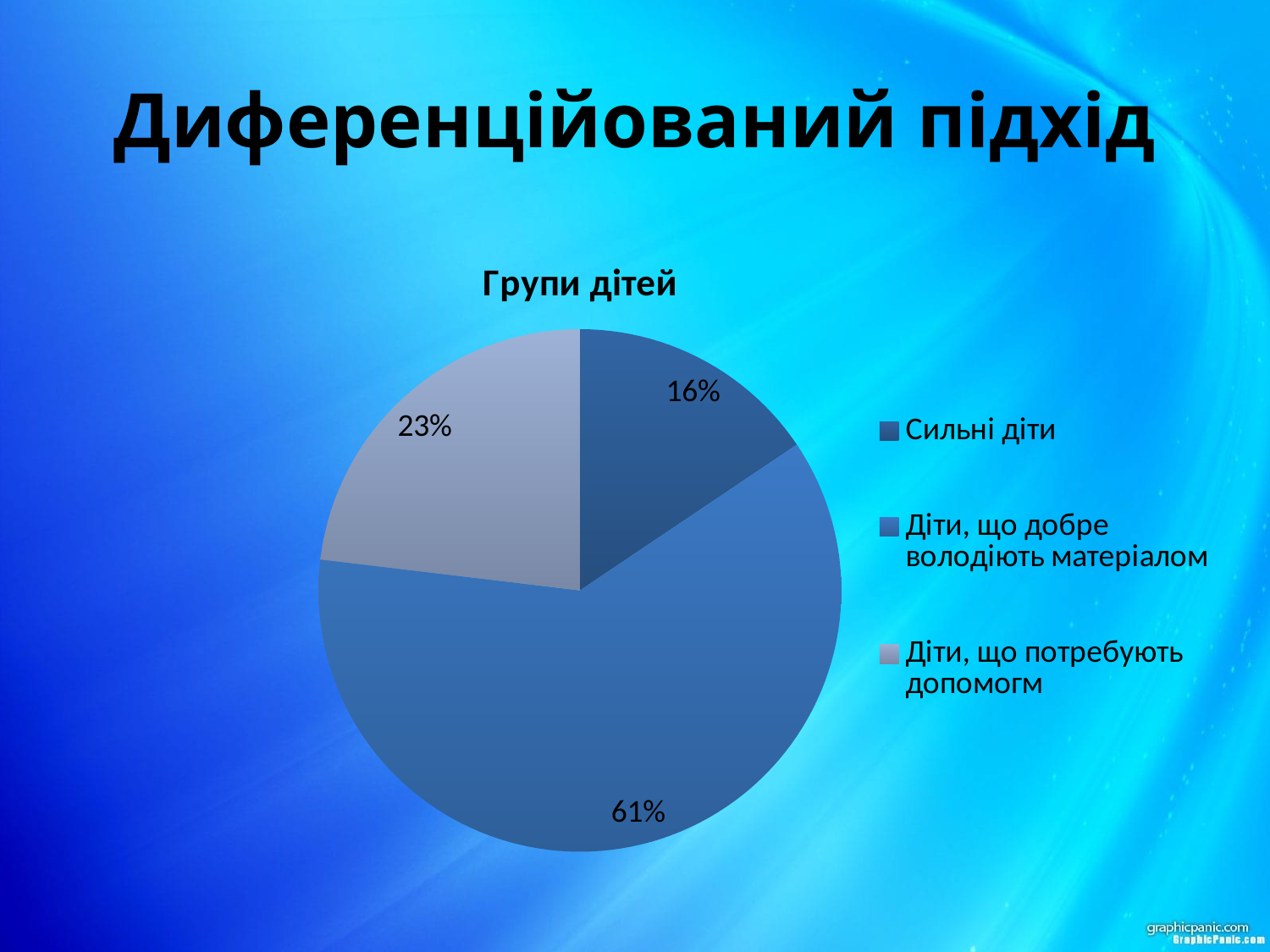
How many slices does the pie chart have? 3 Which is larger: the slice for "Сильні діти" or the slice for "Діти, що потребують допомогм"? Діти, що потребують допомогм What is the title of the chart? Групи дітей What is the difference in percentage points between "Діти, що потребують допомогм" and "Сильні діти"? 7 How many entries does the legend list? 3 What is the difference in percentage points between "Діти, що добре володіють матеріалом" and "Діти, що потребують допомогм"? 38 What share of the pie is labelled "Сильні діти"? 16% Which group has the largest slice of the pie? Діти, що добре володіють матеріалом Which group has the smallest slice of the pie? Сильні діти What share of the pie is labelled "Діти, що потребують допомогм"? 23% What kind of chart is shown on the slide? pie chart What share of the pie is labelled "Діти, що добре володіють матеріалом"? 61%